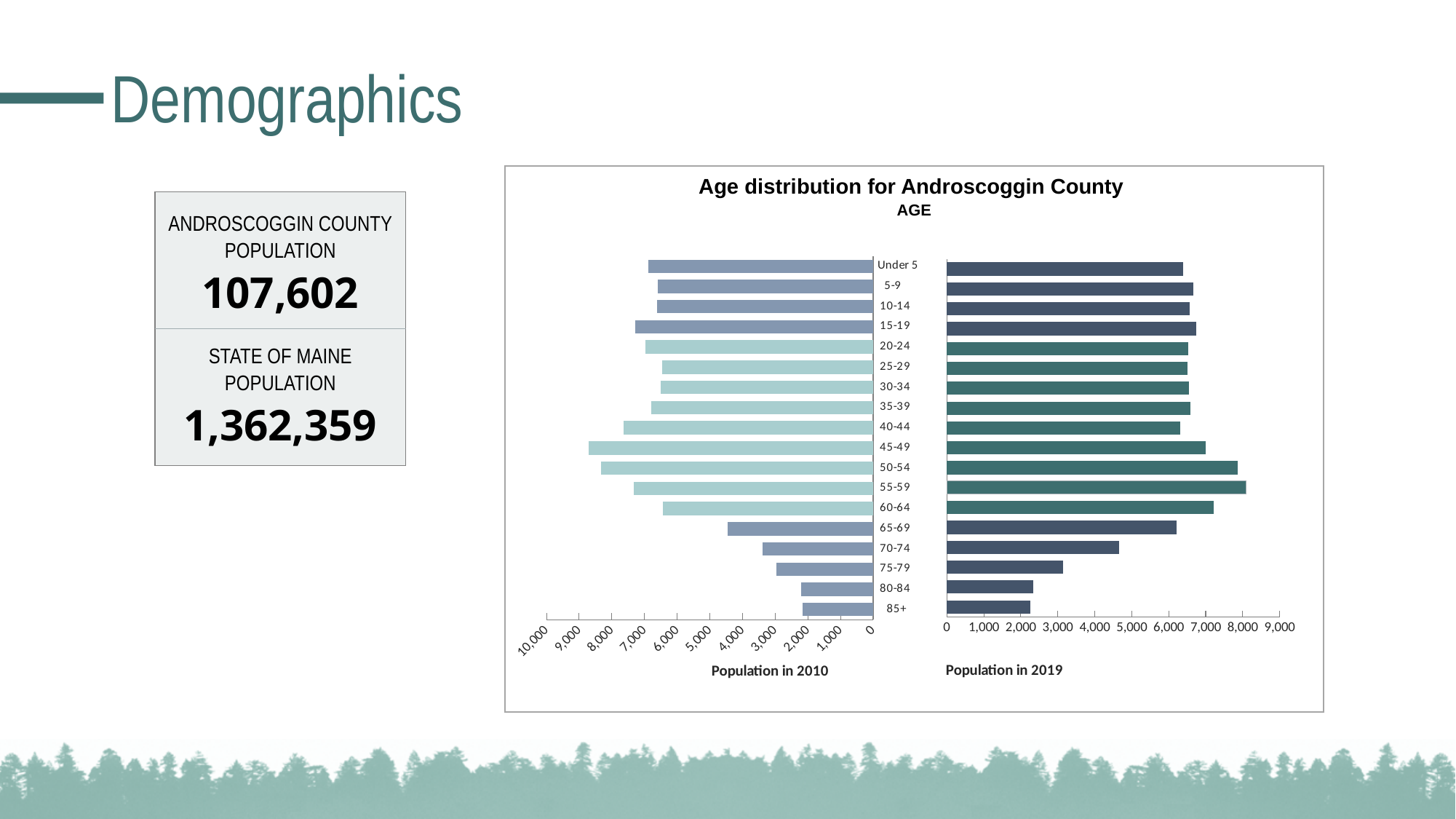
For the 45-49 age group, which is larger: the population in 2010 or the population in 2019? Population in 2010 In the Population in 2019 chart, is the value for the 70-74 age group greater or less than 4,000? greater In the Population in 2010 chart, which age group has the highest population? 45-49 In the Population in 2019 chart, is the value for the 75-79 age group greater or less than 4,000? less In the Population in 2019 chart, which age group has the highest population? 55-59 For the 65-69 age group, which is larger: the population in 2010 or the population in 2019? Population in 2019 Which two years of population data does the chart compare? 2010 and 2019 How many age groups are plotted in the chart? 18 What is the title of the chart? Age distribution for Androscoggin County In the Population in 2010 chart, is the value for the 70-74 age group greater or less than 4,000? less What kind of chart is shown on the slide? Bar chart